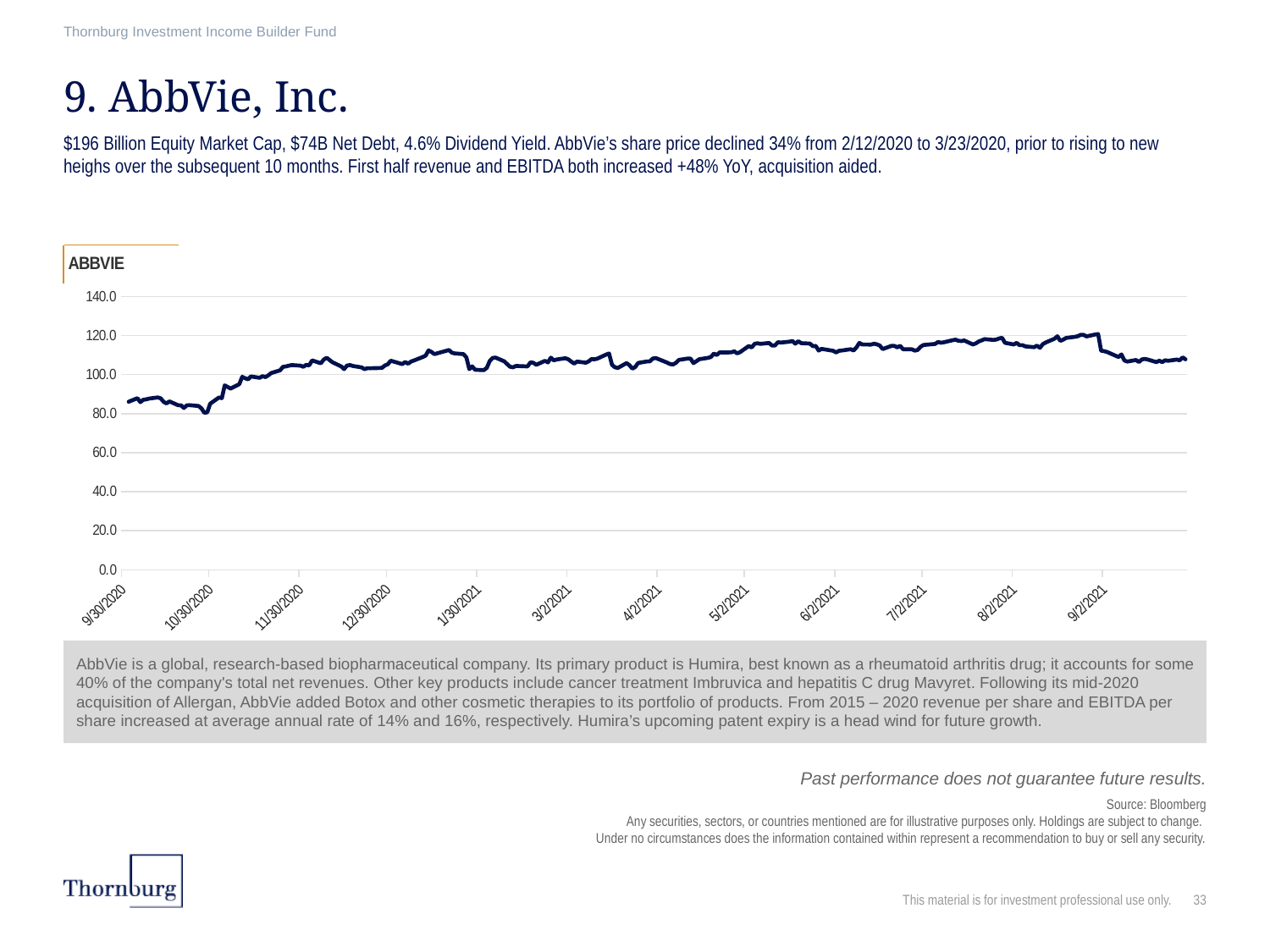
Is the highest point on the line greater or less than 140? less Overall, does the line rise or fall from 9/30/2020 to 9/2/2021? rise Is the value at 9/30/2020 greater or less than 100? less How many date labels are shown on the x axis? 12 What is the title of the chart? ABBVIE Is the value at 10/30/2020 greater or less than 100? less Which is larger, the value at 9/30/2020 or the value at 7/2/2021? 7/2/2021 What kind of chart is shown on the slide? line chart What is the highest value shown on the y axis? 140.0